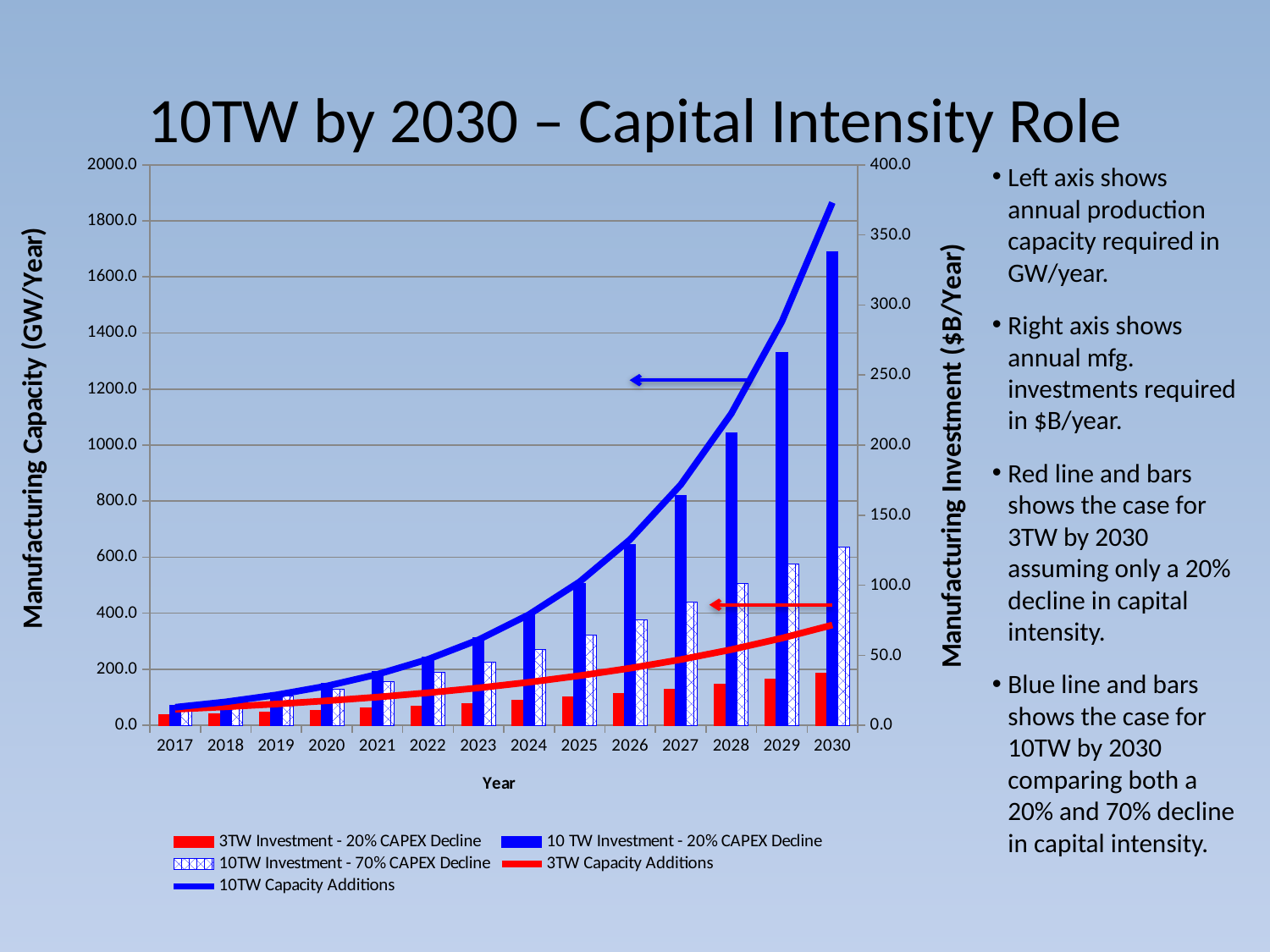
How many years are shown along the x axis of the chart? 14 Do the 10TW Capacity Additions values rise or fall from 2017 to 2030? Rise In 2030, which bar is taller: 10 TW Investment - 20% CAPEX Decline or 10TW Investment - 70% CAPEX Decline? 10 TW Investment - 20% CAPEX Decline Is the 2030 value for 3TW Investment - 20% CAPEX Decline greater or less than 50.0 on the right axis? less What is the title of the chart's left vertical axis? Manufacturing Capacity (GW/Year) Is the 2030 value for 10 TW Investment - 20% CAPEX Decline greater or less than 300.0 on the right axis? greater Which year has the shortest bar for 10 TW Investment - 20% CAPEX Decline? 2017 Is the 2030 value for 10TW Investment - 70% CAPEX Decline greater or less than 150.0 on the right axis? less How many series does the chart's legend list? 5 What kind of chart is shown on the slide? A combined bar and line chart Which year has the tallest bar for 10 TW Investment - 20% CAPEX Decline? 2030